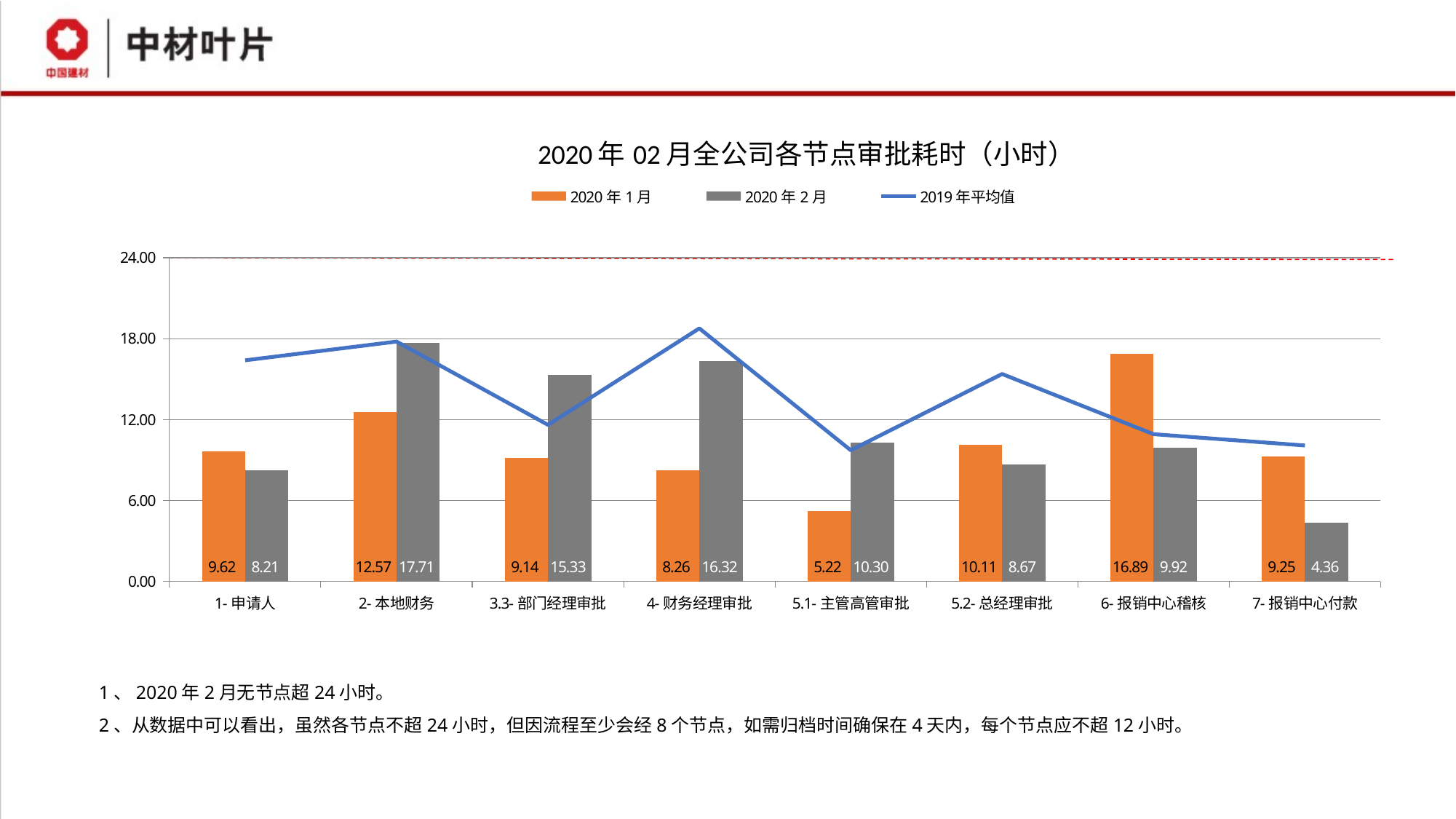
What is the difference between the 2020年2月 and 2020年1月 values for 2- 本地财务? 5.14 Is the 2019年平均值 for 5.1- 主管高管审批 greater or less than 12.00? less How many categories are shown on the x axis? 8 What is the title of the chart? 2020年02月全公司各节点审批耗时（小时） For 4- 财务经理审批, which is larger: the 2020年1月 value or the 2020年2月 value? 2020年2月 What is the 2020年1月 value for 6- 报销中心稽核? 16.89 What is the 2020年2月 value for 7- 报销中心付款? 4.36 How many series does the legend list? 3 Is the 2019年平均值 for 4- 财务经理审批 greater or less than 18.00? greater What is the 2020年2月 value for 2- 本地财务? 17.71 Which category has the lowest 2020年1月 value? 5.1- 主管高管审批 Which category has the highest 2020年2月 value? 2- 本地财务